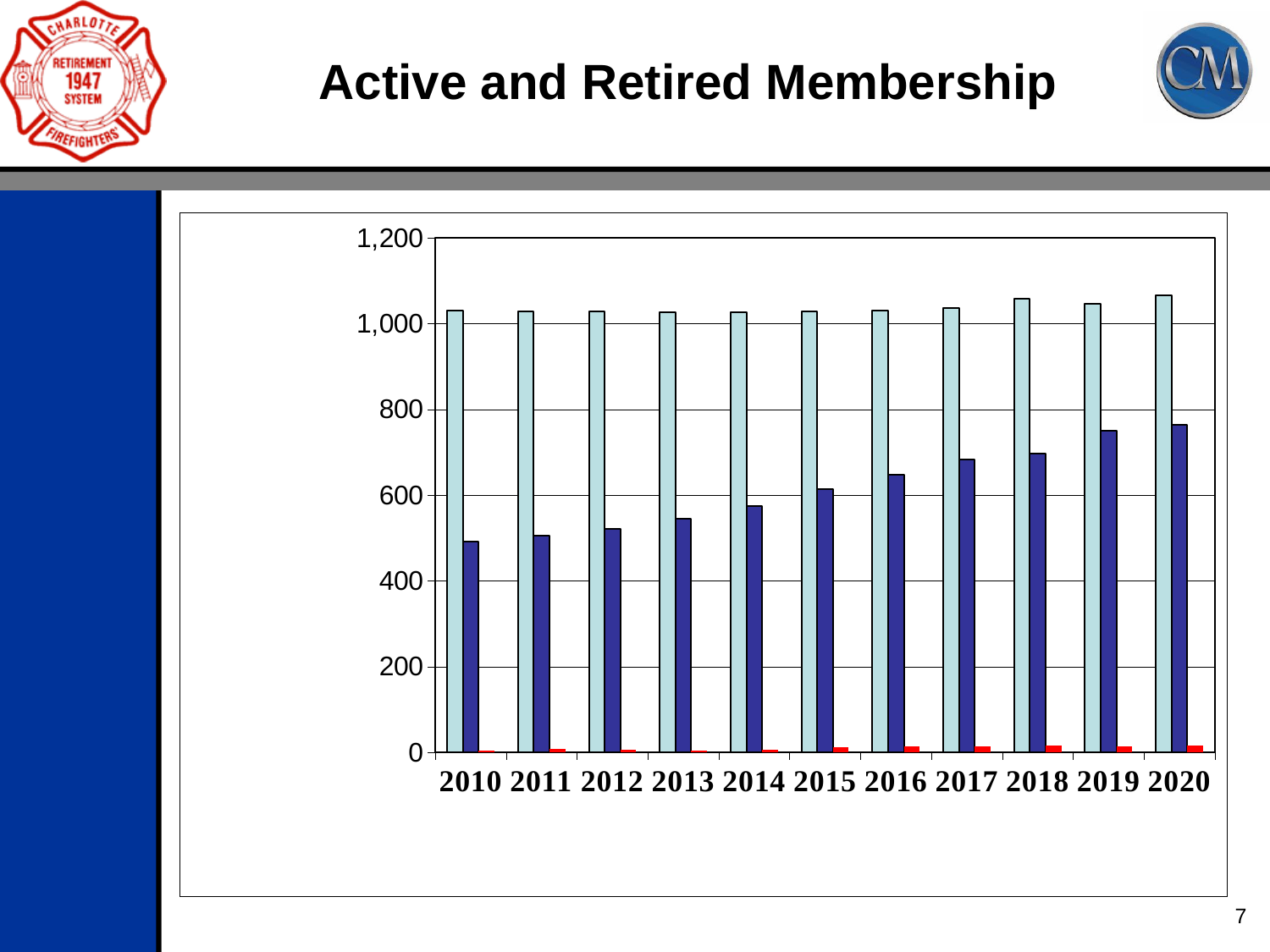
Is the value of the dark blue bar for 2010 greater or less than 600? less How many years are shown along the x axis of the chart? 11 Is the value of the red bar for 2015 greater or less than 200? less In which year is the dark blue bar the lowest? 2010 Is the value of the dark blue bar for 2020 greater or less than 600? greater In 2020, which is larger: the light blue bar or the dark blue bar? the light blue bar What kind of chart is shown on the slide? bar chart Do the dark blue bars rise or fall from 2010 to 2020? rise How many differently coloured bar series are plotted for each year? 3 What is the title of the slide containing the chart? Active and Retired Membership In which year is the dark blue bar the highest? 2020